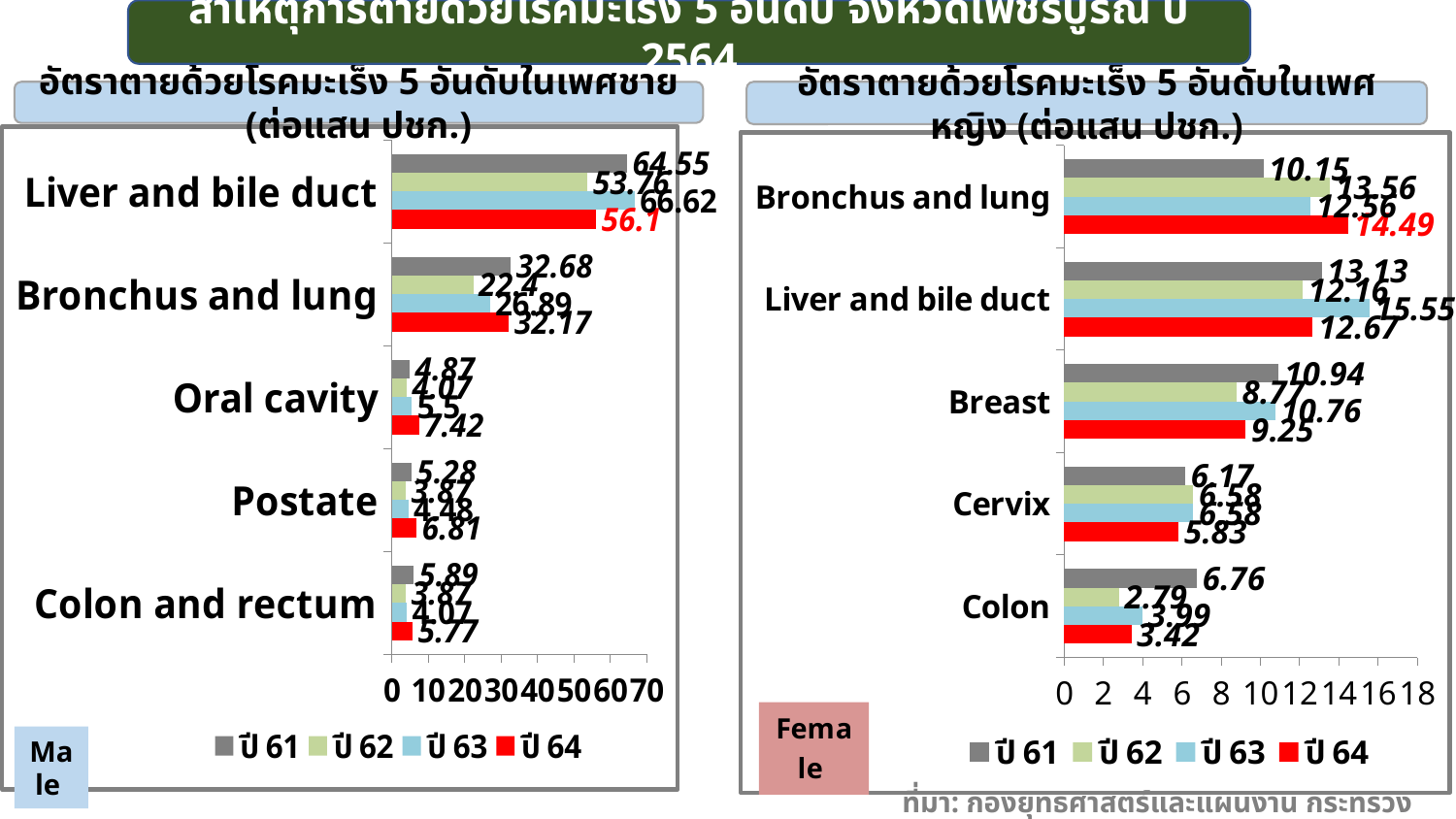
What type of chart is the Female chart on the right? Bar chart In the Female chart on the right, what is the value for Liver and bile duct in ปี 63? 15.55 In the Male chart on the left, which category has the highest value in ปี 63? Liver and bile duct In the Female chart on the right, what is the value for Bronchus and lung in ปี 64? 14.49 In the Male chart on the left, what is the difference between the ปี 63 and ปี 64 values for Liver and bile duct? 10.52 In the Female chart on the right, what is the value for Colon in ปี 62? 2.79 In the Male chart on the left, how many series does the legend list? 4 In the Female chart on the right, which is larger for Breast: the ปี 61 value or the ปี 62 value? ปี 61 In the Male chart on the left, what is the value for Liver and bile duct in ปี 64? 56.1 In the Female chart on the right, how many categories are shown? 5 In the Male chart on the left, what is the value for Bronchus and lung in ปี 61? 32.68 In the Male chart on the left, what is the value for Oral cavity in ปี 64? 7.42